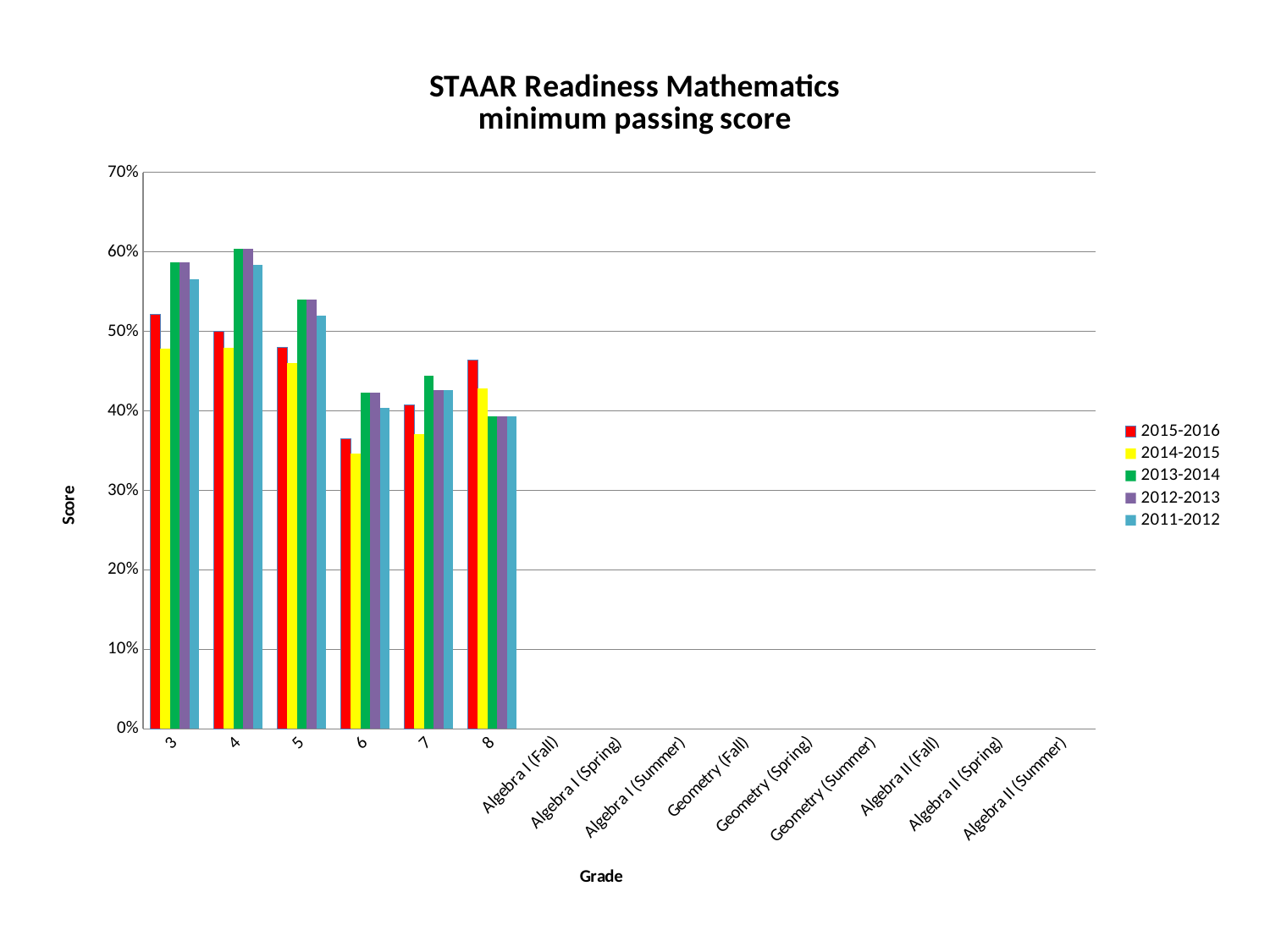
For grade 8, which is larger: the 2015-2016 value or the 2014-2015 value? 2015-2016 How many series does the legend list? 5 Among the grades with plotted bars, which grade has the highest 2015-2016 value? 3 What is the title of the chart? STAAR Readiness Mathematics minimum passing score Is the 2011-2012 value for grade 5 greater or less than 50%? greater What kind of chart is shown on the slide? bar chart Among the grades with plotted bars, which grade has the lowest 2014-2015 value? 6 Is the 2013-2014 value for grade 4 greater or less than 50%? greater Do the 2014-2015 values rise or fall from grade 3 to grade 6? fall For grade 7, which is larger: the 2013-2014 value or the 2015-2016 value? 2013-2014 How many categories are labelled along the x axis? 15 Is the 2015-2016 value for grade 6 greater or less than 40%? less